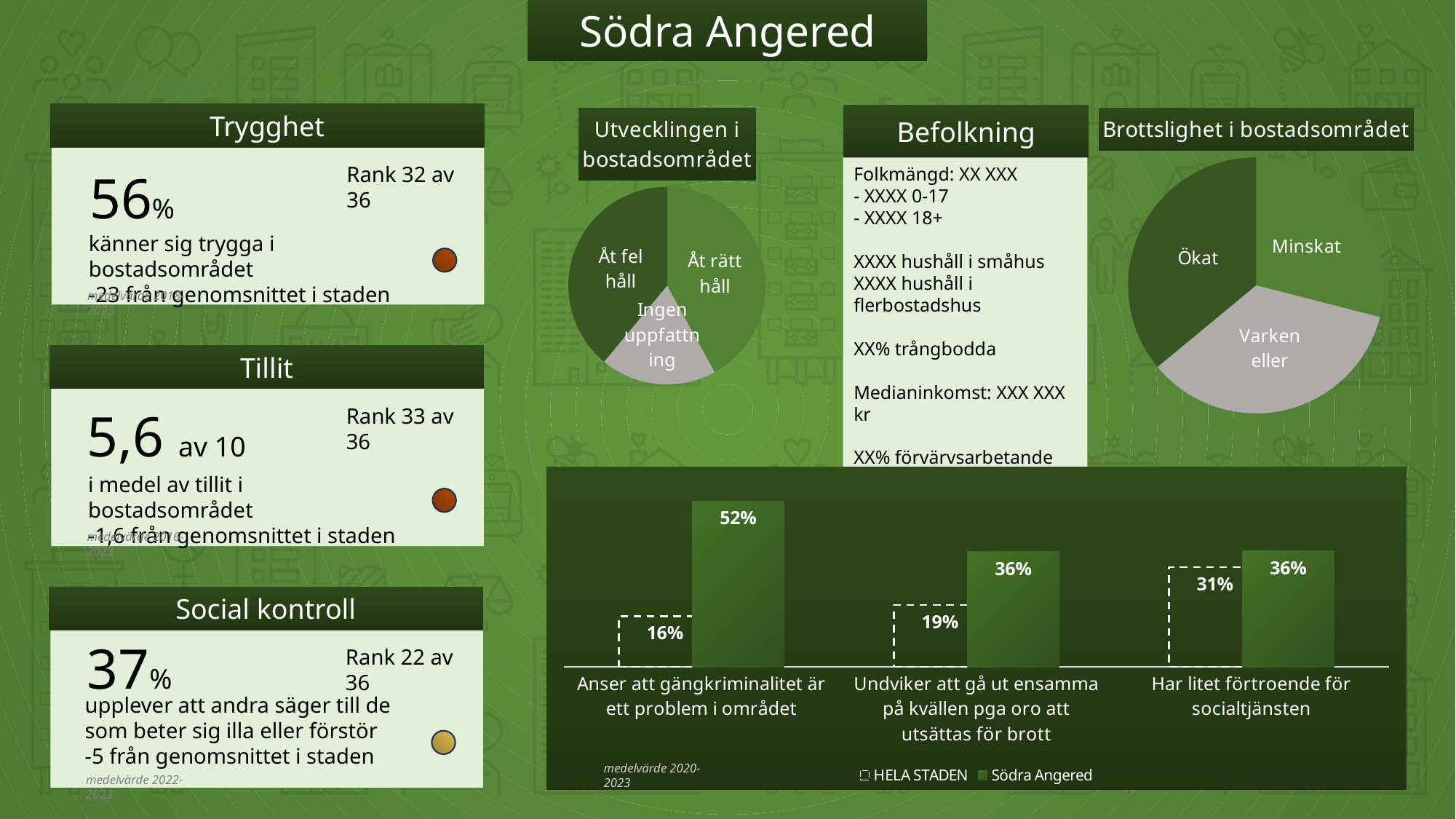
How many slices does the pie chart titled "Brottslighet i bostadsområdet" have? 3 In the bar chart at the bottom of the slide, what is the value for HELA STADEN for "Har litet förtroende för socialtjänsten"? 31% In the bar chart at the bottom of the slide, how many series does the legend list? 2 In the bar chart at the bottom of the slide, what is the value for HELA STADEN for "Undviker att gå ut ensamma på kvällen pga oro att utsättas för brott"? 19% In the bar chart at the bottom of the slide, what is the difference between Södra Angered and HELA STADEN for "Undviker att gå ut ensamma på kvällen pga oro att utsättas för brott"? 17% In the bar chart at the bottom of the slide, which category has the highest value for Södra Angered? Anser att gängkriminalitet är ett problem i området In the bar chart at the bottom of the slide, what is the value for Södra Angered for "Har litet förtroende för socialtjänsten"? 36% In the bar chart at the bottom of the slide, what is the difference between Södra Angered and HELA STADEN for "Anser att gängkriminalitet är ett problem i området"? 36% In the bar chart at the bottom of the slide, what is the value for HELA STADEN for "Anser att gängkriminalitet är ett problem i området"? 16% What kind of chart is the chart titled "Utvecklingen i bostadsområdet"? Pie chart In the bar chart at the bottom of the slide, which category has the lowest value for HELA STADEN? Anser att gängkriminalitet är ett problem i området In the bar chart at the bottom of the slide, what is the value for Södra Angered for "Anser att gängkriminalitet är ett problem i området"? 52%